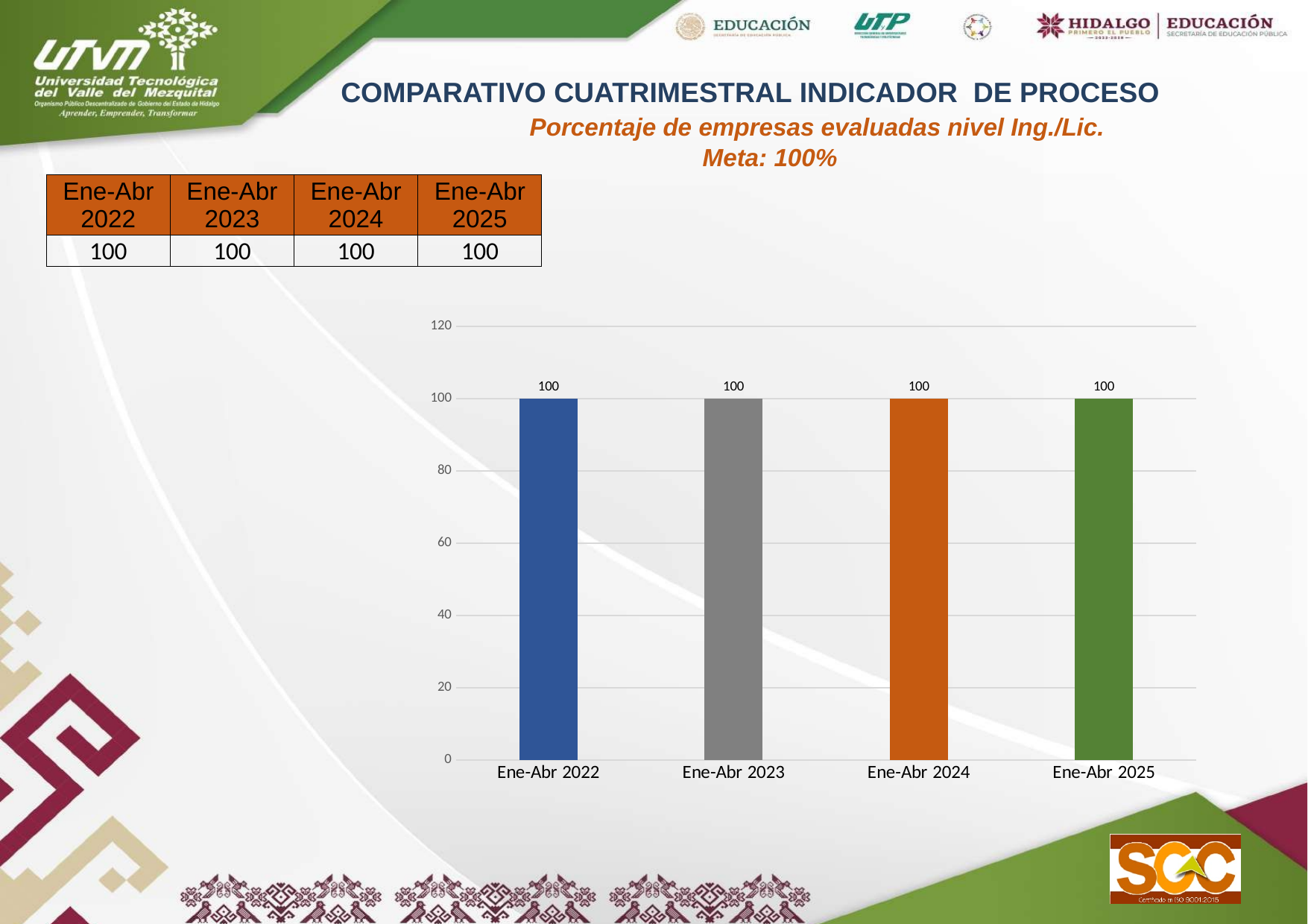
What is the difference between the values for Ene-Abr 2023 and Ene-Abr 2022? 0 What is the value for Ene-Abr 2024? 100 How many categories are shown on the x axis of the chart? 4 What is the highest value shown on the y axis of the chart? 120 What kind of chart is shown on the slide? bar chart What colour is the bar for Ene-Abr 2024? orange Do the values rise, fall, or stay flat from Ene-Abr 2022 to Ene-Abr 2025? stay flat Is the value for Ene-Abr 2024 greater or less than 120? less What is the value for Ene-Abr 2025? 100 What is the value for Ene-Abr 2022? 100 Is the value for Ene-Abr 2023 greater or less than 80? greater